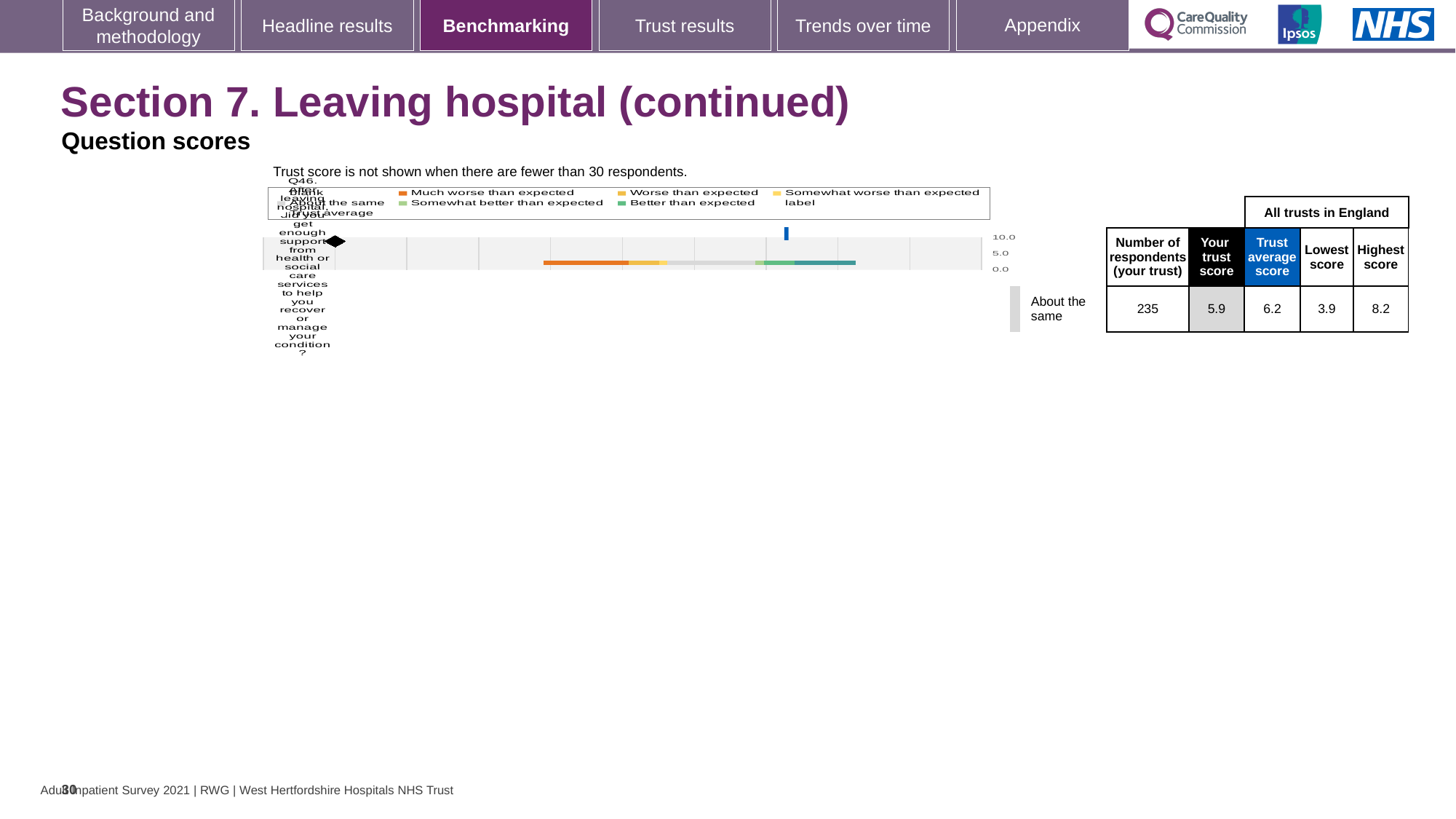
What is the difference between the highest score (8.2) and the lowest score (3.9) for Q46? 4.3 What kind of chart is shown on the slide for Q46? bar chart Which is larger for Q46: your trust score or the trust average score? Trust average score According to the table beside the chart, what is the trust average score for Q46? 6.2 Which question number is plotted in the chart? Q46 Is your trust score for Q46 greater or less than 5.0? greater How many survey questions are plotted in the chart on this slide? 1 According to the table beside the chart, what is the lowest score among all trusts in England for Q46? 3.9 According to the table beside the chart, how many respondents from your trust answered Q46? 235 According to the table beside the chart, what is your trust score for Q46? 5.9 According to the table beside the chart, what is the highest score among all trusts in England for Q46? 8.2 What benchmark category is shown next to the chart for Q46? About the same